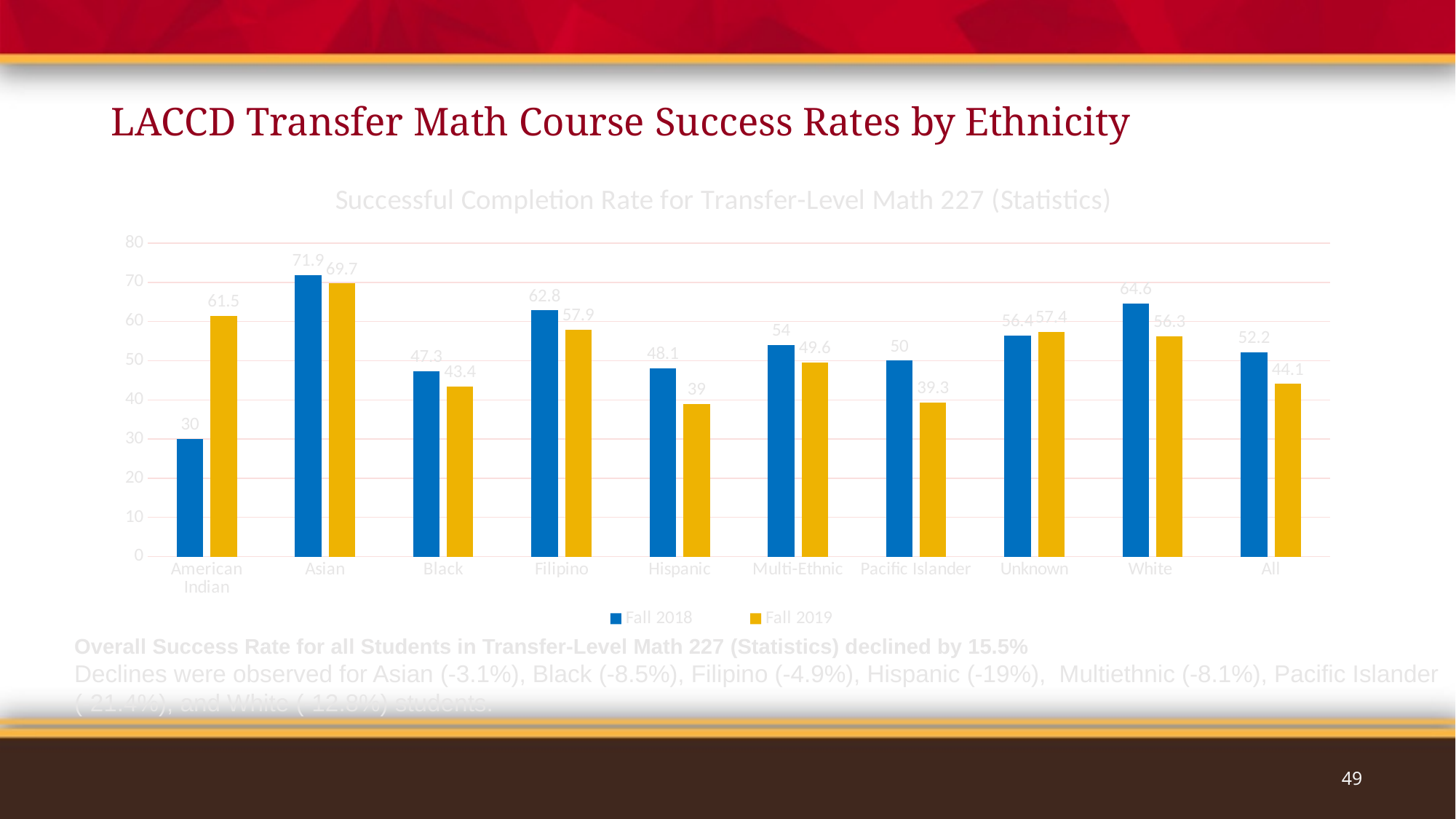
What kind of chart is shown on the slide? Bar chart What is the title of the chart? Successful Completion Rate for Transfer-Level Math 227 (Statistics) What is the difference between the Fall 2018 and Fall 2019 values for White? 8.3 Which is larger for Unknown, the Fall 2018 value or the Fall 2019 value? Fall 2019 Which category has the highest Fall 2018 value? Asian What is the Fall 2018 value for Asian? 71.9 How many categories are shown on the x axis? 10 What is the Fall 2019 value for American Indian? 61.5 What is the Fall 2018 value for All? 52.2 What is the Fall 2019 value for Hispanic? 39 Which category has the lowest Fall 2018 value? American Indian How many series does the legend list? 2